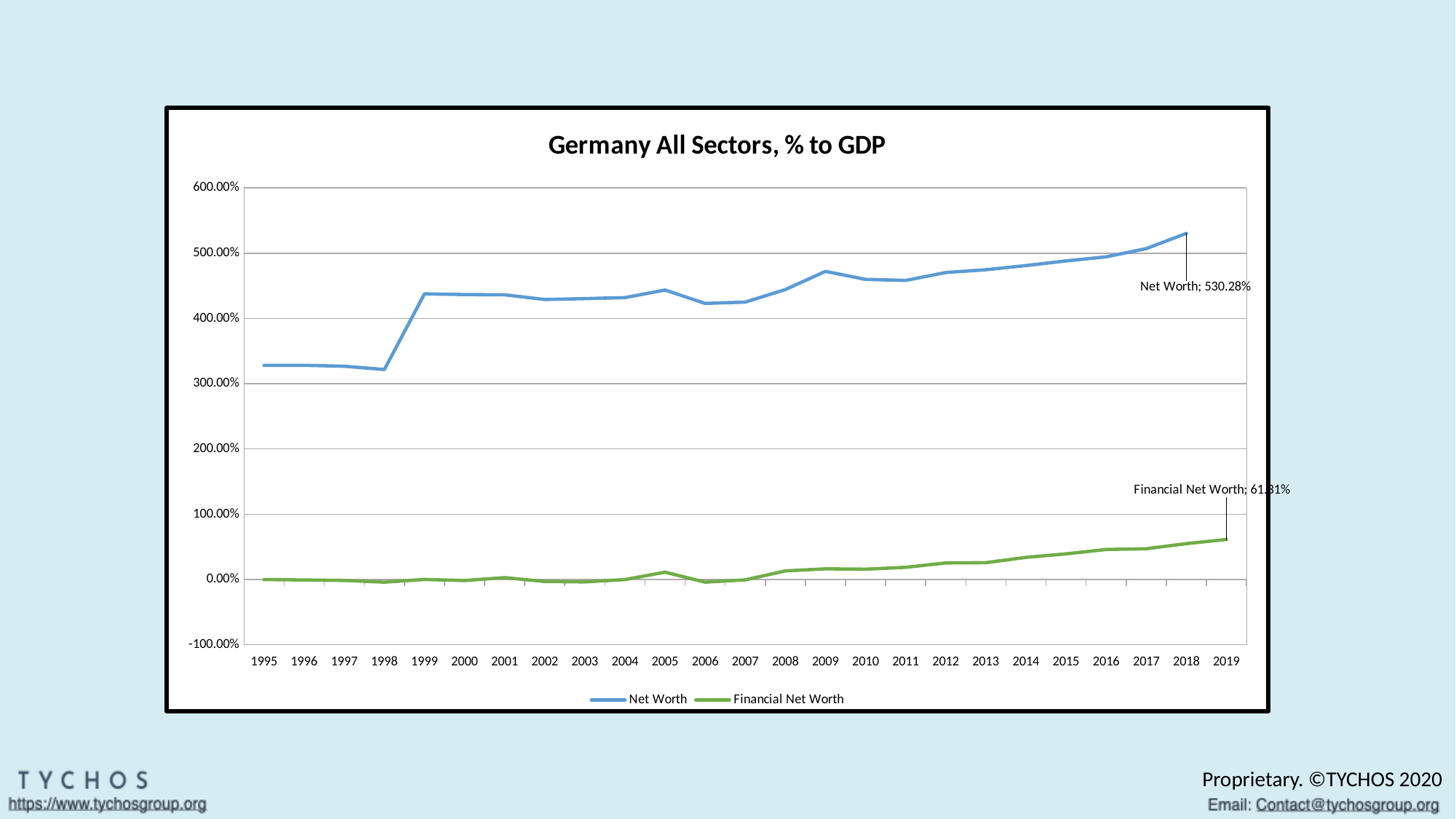
Is the Net Worth value for 2009 greater or less than 400.00%? greater In 2010, which series has the larger value, Net Worth or Financial Net Worth? Net Worth How many years are shown on the x axis? 25 Is the Net Worth value for 1995 greater or less than 400.00%? less In which year is the Net Worth series at its highest? 2018 What kind of chart is shown on the slide? line chart What is the Net Worth value labelled for 2018? 530.28% What is the title of the chart? Germany All Sectors, % to GDP Is the Financial Net Worth value for 2019 greater or less than 100.00%? less In which year is the Net Worth series at its lowest? 1998 Does the Financial Net Worth series rise or fall from 2008 to 2019? rise How many series does the legend list? 2